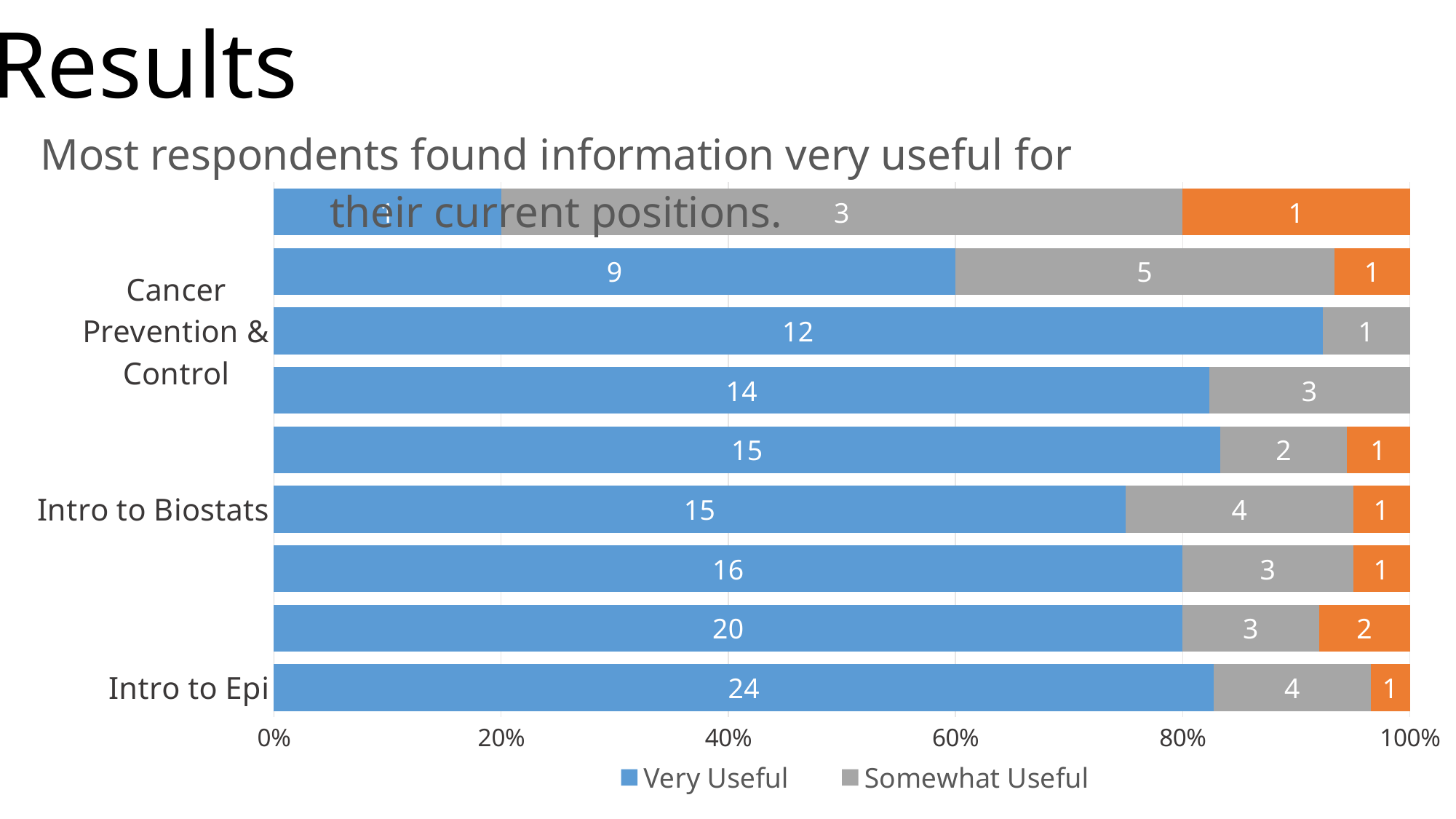
What is the total of all segments in the Intro to Epi bar? 29 Is the Very Useful share of the Intro to Biostats bar greater or less than 80%? less What kind of chart is shown on the slide? Stacked bar chart What is the Very Useful value for Intro to Biostats? 15 What is the Somewhat Useful value for Intro to Epi? 4 What is the Somewhat Useful value for Intro to Biostats? 4 Which has a larger Very Useful value, Intro to Epi or Intro to Biostats? Intro to Epi What is the Very Useful value for Intro to Epi? 24 What is the difference between the Very Useful values for Intro to Epi and Intro to Biostats? 9 What is the total of all segments in the Intro to Biostats bar? 20 How many series does the legend list? 2 How many bars are plotted in the chart? 9